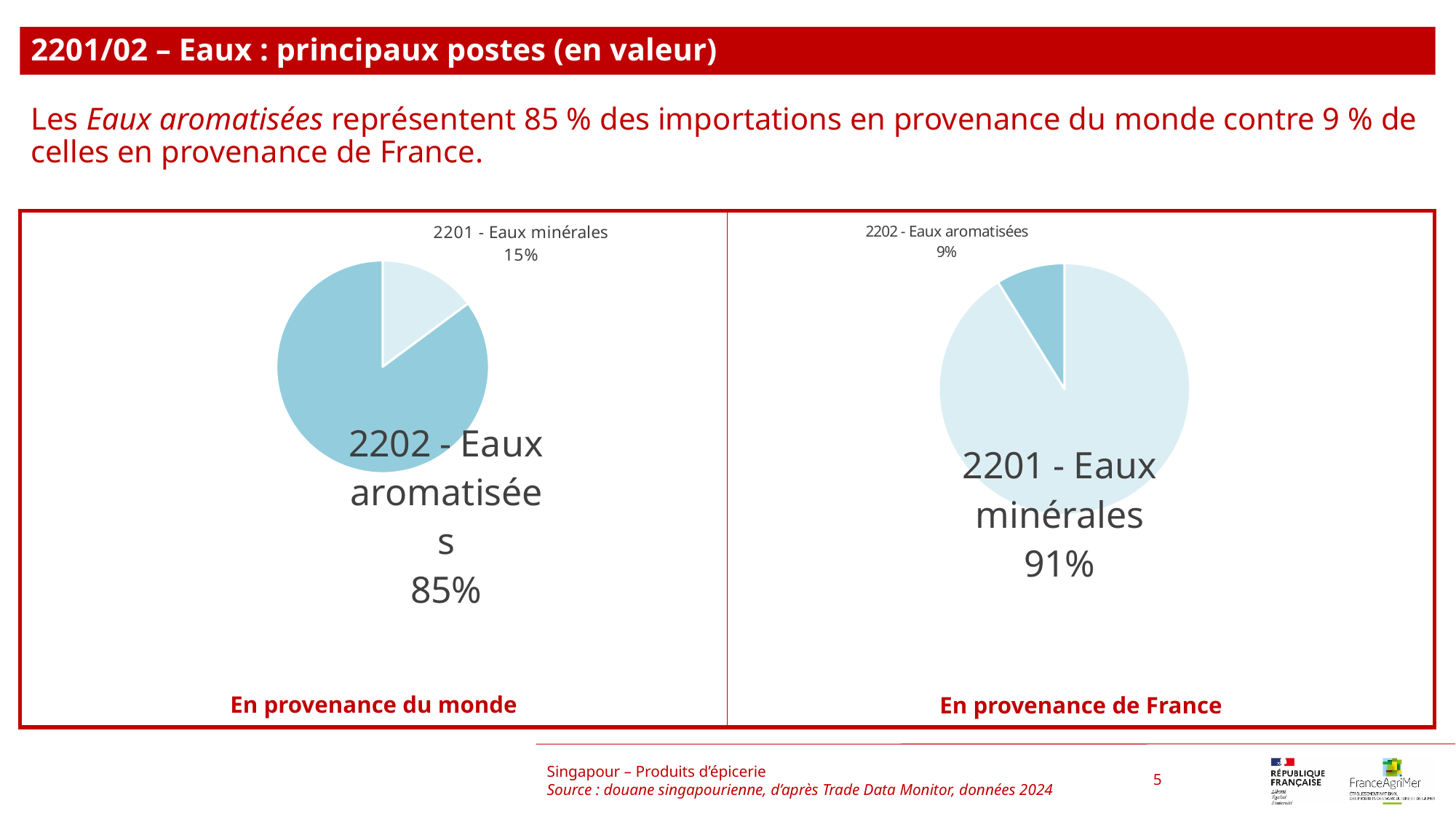
What is the caption under the right-hand pie chart? En provenance de France In the 'En provenance du monde' pie chart, what is the difference in percentage points between the two slices? 70 What type of chart is used on the left side of the slide ('En provenance du monde')? Pie chart In the 'En provenance du monde' pie chart, what share does '2202 - Eaux aromatisées' have? 85% In the 'En provenance de France' pie chart, what is the difference in percentage points between the two slices? 82 In the 'En provenance du monde' pie chart, which category has the largest share? 2202 - Eaux aromatisées In the 'En provenance de France' pie chart, what share does '2201 - Eaux minérales' have? 91% In the 'En provenance de France' pie chart, which category has the smallest share? 2202 - Eaux aromatisées How many slices does the 'En provenance de France' pie chart have? 2 Which is larger: the share of '2202 - Eaux aromatisées' in the 'En provenance du monde' chart or in the 'En provenance de France' chart? En provenance du monde In the 'En provenance de France' pie chart, what share does '2202 - Eaux aromatisées' have? 9% In the 'En provenance du monde' pie chart, what share does '2201 - Eaux minérales' have? 15%